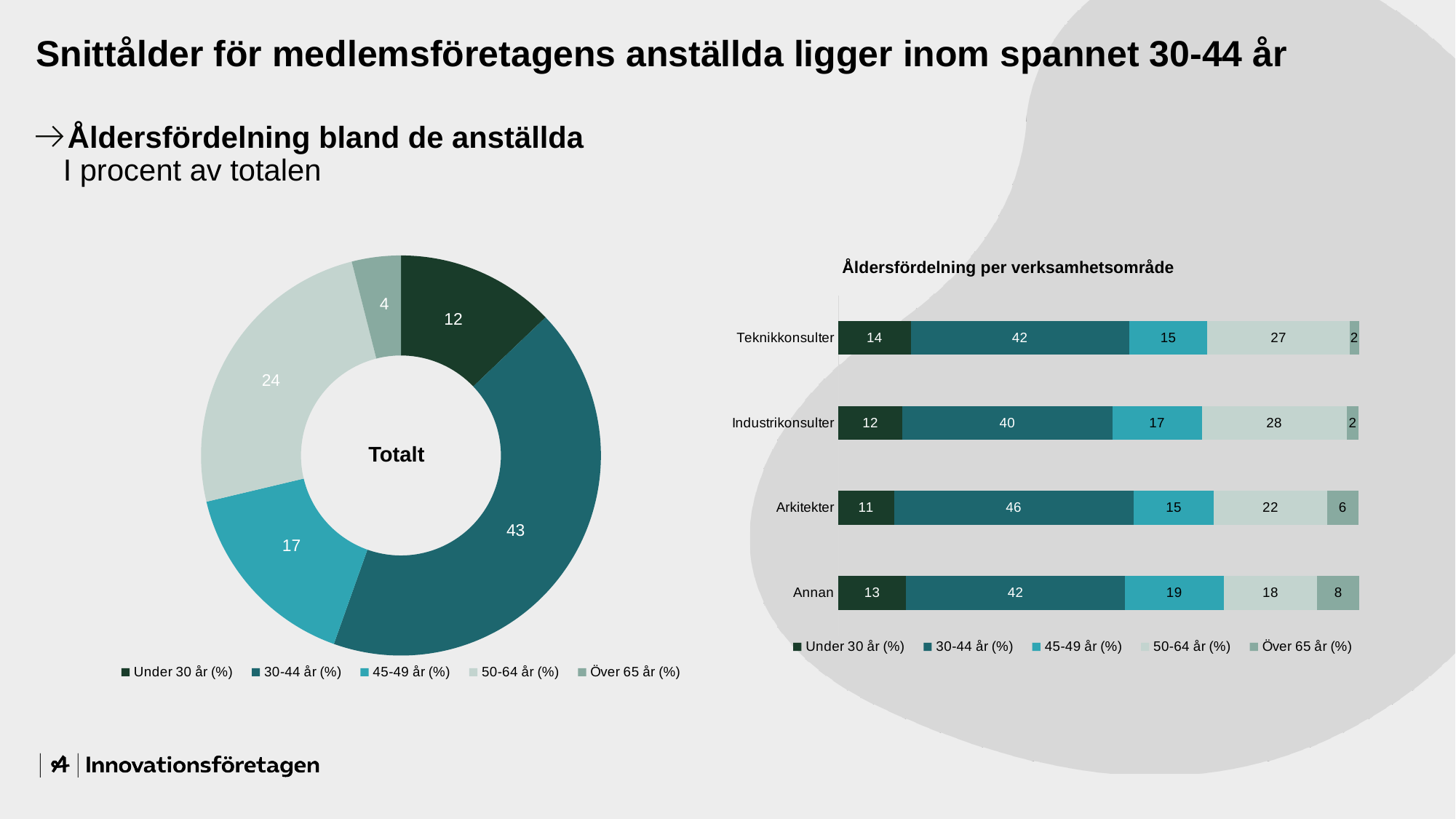
In the chart Åldersfördelning per verksamhetsområde, which category has the lowest 50-64 år (%) value? Annan In the donut chart on the left (Totalt), what is the value for 30-44 år (%)? 43 In the chart Åldersfördelning per verksamhetsområde, what is the difference between the 50-64 år (%) values for Industrikonsulter and Arkitekter? 6 In the chart Åldersfördelning per verksamhetsområde, is the 45-49 år (%) value larger for Annan or for Teknikkonsulter? Annan In the donut chart on the left (Totalt), which age group has the smallest share? Över 65 år (%) How many series does the legend of the chart Åldersfördelning per verksamhetsområde list? 5 What kind of chart is the chart on the left titled Totalt? Donut (pie) chart In the donut chart on the left (Totalt), what is the difference between the 50-64 år value and the 45-49 år value? 7 In the chart Åldersfördelning per verksamhetsområde, what is the 30-44 år (%) value for Arkitekter? 46 In the chart Åldersfördelning per verksamhetsområde, which category has the highest 30-44 år (%) value? Arkitekter In the chart Åldersfördelning per verksamhetsområde, what is the Över 65 år (%) value for Annan? 8 How many categories are shown in the chart Åldersfördelning per verksamhetsområde? 4